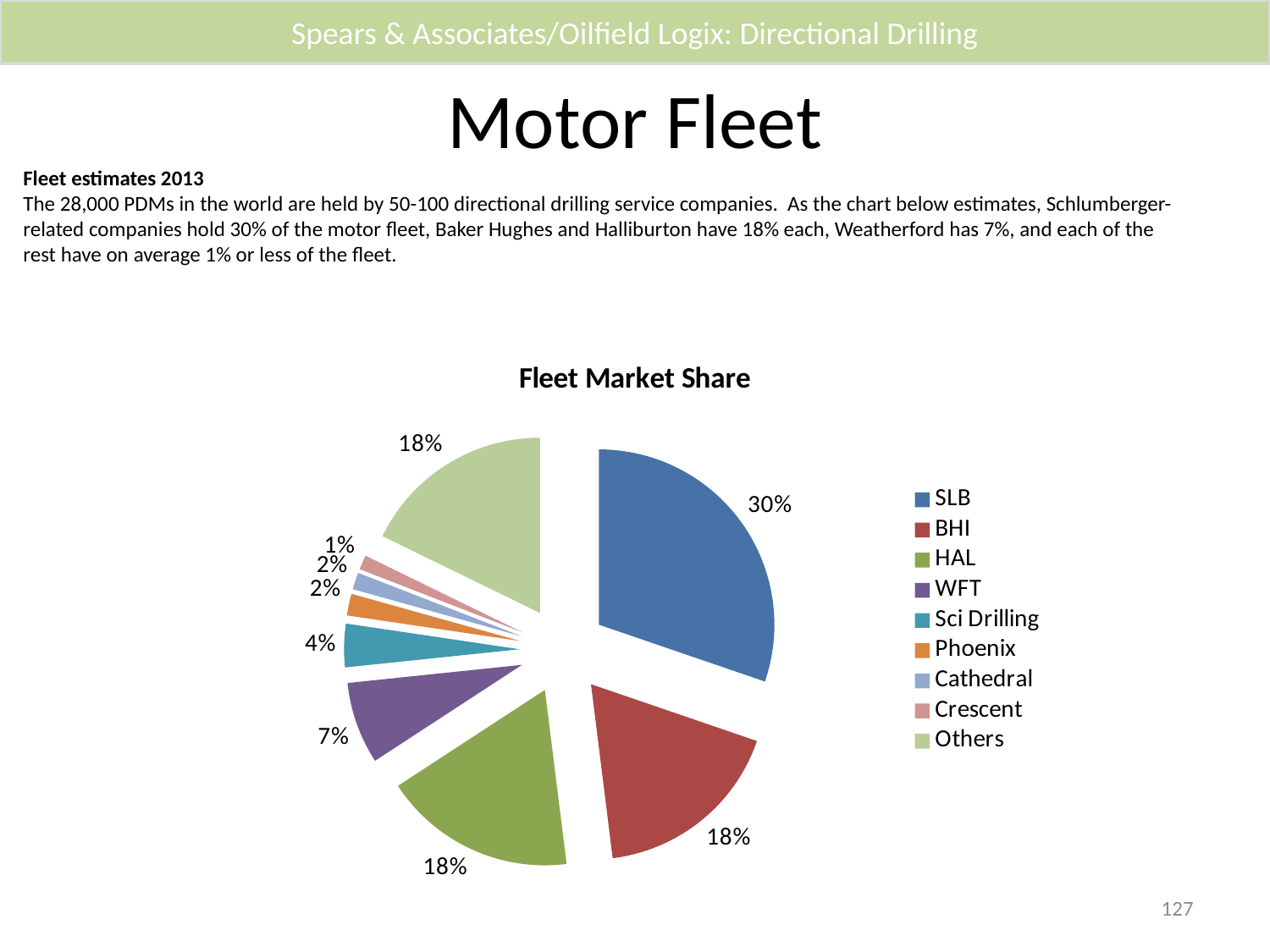
What share of the fleet market does Others hold according to the pie chart? 18% Which has a larger share in the pie chart, WFT or Sci Drilling? WFT How many percentage points larger is SLB's share than WFT's share in the pie chart? 23 What share of the fleet market does Sci Drilling hold according to the pie chart? 4% What share of the fleet market does Crescent hold according to the pie chart? 1% What share of the fleet market does WFT hold according to the pie chart? 7% Which company has the smallest slice in the Fleet Market Share pie chart? Crescent What type of chart is shown under the title "Fleet Market Share"? pie chart What is the title of the pie chart on the slide? Fleet Market Share Which company has the largest slice in the Fleet Market Share pie chart? SLB How many entries does the legend of the Fleet Market Share pie chart list? 9 What share of the fleet market does SLB hold according to the pie chart? 30%